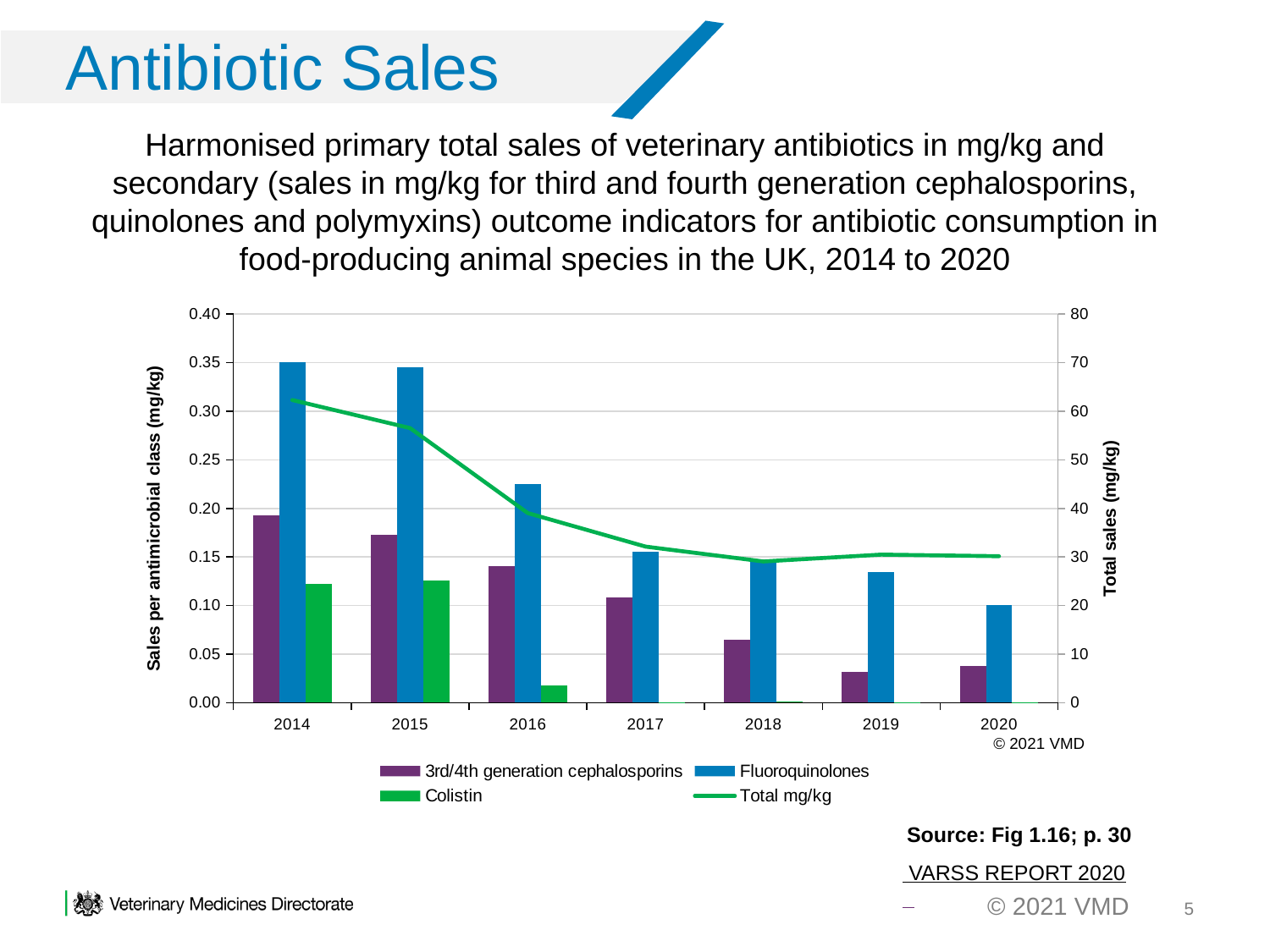
How many years are shown on the x axis of the chart? 7 In which year is the 3rd/4th generation cephalosporins bar highest? 2014 Which series in the chart is plotted as a line rather than bars? Total mg/kg What colour are the Colistin bars in the chart? green In 2015, which is larger: the Fluoroquinolones bar or the Colistin bar? Fluoroquinolones Is the Total mg/kg value for 2017 greater or less than 40? less Is the 3rd/4th generation cephalosporins value for 2018 greater or less than 0.10? less How many series does the chart legend list? 4 In which year is the Fluoroquinolones bar lowest? 2020 Does the Total mg/kg line generally rise or fall from 2014 to 2020? fall Is the Fluoroquinolones value for 2016 greater or less than 0.20? greater